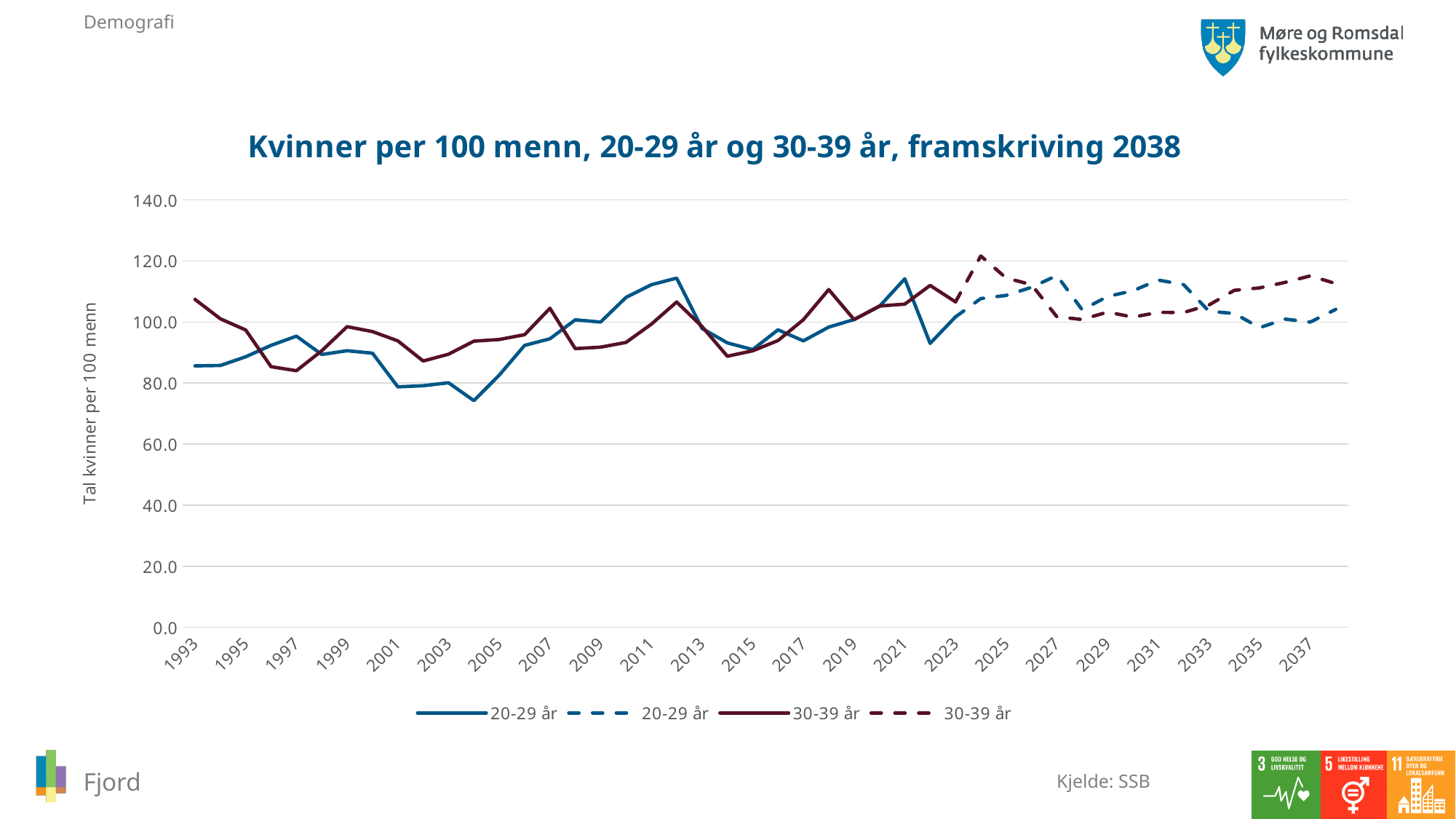
In 1993, which series has the higher value, 20-29 år or 30-39 år? 30-39 år How many series does the legend list? 4 Is the value for 30-39 år in 1993 greater or less than 100? greater Is the value for 20-29 år in 2004 greater or less than 80? less Is the value for 20-29 år in 2012 greater or less than 100? greater In 2012, which series has the higher value, 20-29 år or 30-39 år? 20-29 år Does the 30-39 år line rise or fall from 1993 to 1997? fall What kind of chart is shown on the slide? line chart What is the label on the y axis? Tal kvinner per 100 menn What is the title of the chart? Kvinner per 100 menn, 20-29 år og 30-39 år, framskriving 2038 In which year does the solid 20-29 år line reach its lowest value? 2004